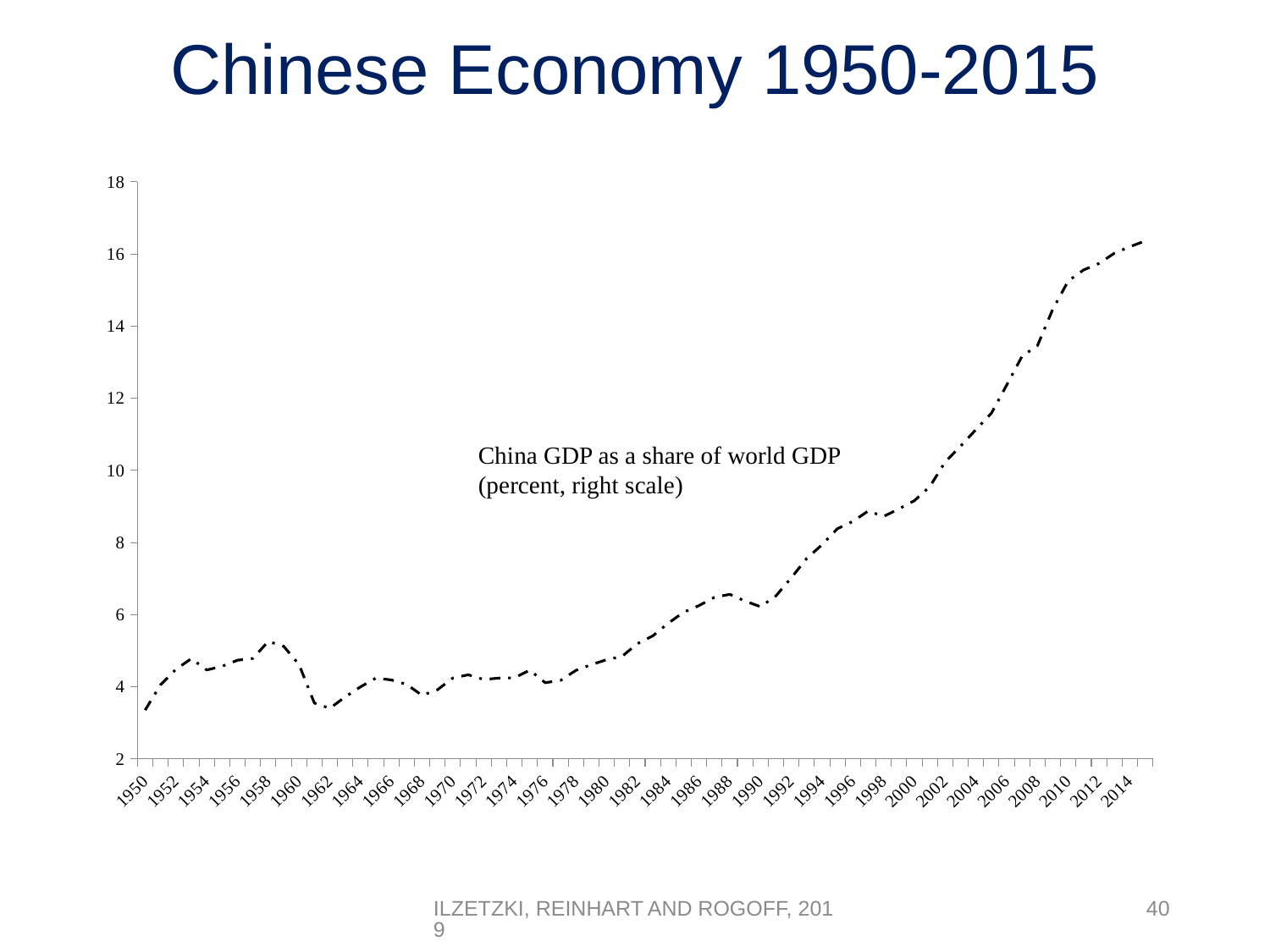
Is the value for 1950 greater or less than 4? less Is the value for 2014 greater or less than 14? greater According to the text annotation on the chart, what does the plotted line represent? China GDP as a share of world GDP (percent, right scale) Is the value for 1980 greater or less than 6? less Between 1958 and 1962, does the plotted value rise or fall? Fall Which year has the larger value, 1980 or 2000? 2000 In which year shown on the x axis is China's GDP share of world GDP highest? 2014 What kind of chart is shown on the slide? Line chart What is the title of the slide's chart? Chinese Economy 1950-2015 Overall, does China's GDP share of world GDP rise or fall from 1950 to 2014? Rise Which year has the larger value, 1958 or 1962? 1958